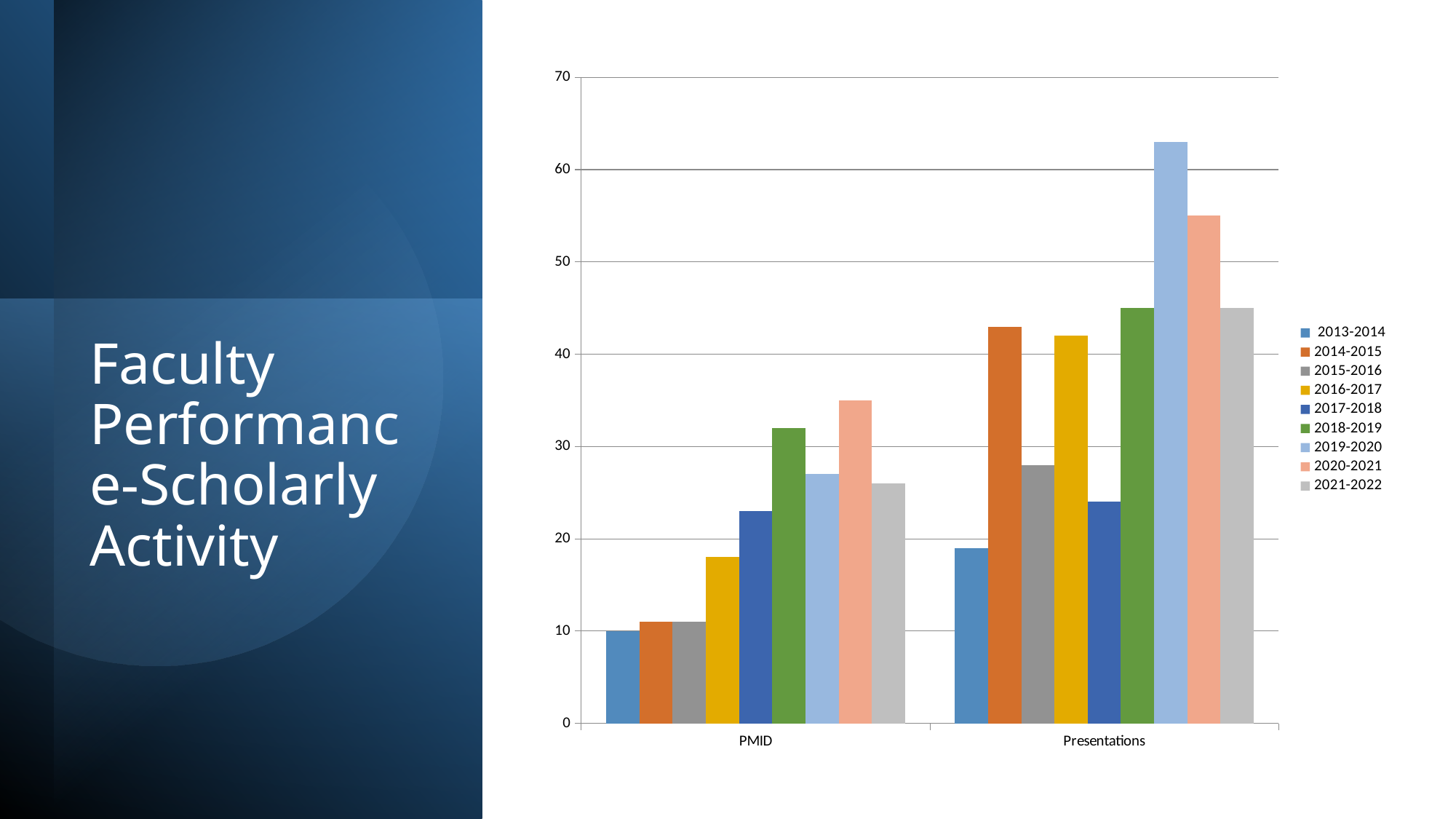
Is the value for 2019-2020 Presentations greater or less than 60? greater Is the value for 2016-2017 PMID greater or less than 20? less Is the value for 2020-2021 PMID greater or less than 30? greater Which series has the highest value for PMID? 2020-2021 Which series has the lowest value for PMID? 2013-2014 What is the title of the slide containing the chart? Faculty Performance-Scholarly Activity Which series has the highest value for Presentations? 2019-2020 Which is larger for PMID: the 2018-2019 value or the 2019-2020 value? 2018-2019 How many categories are shown on the x axis of the chart? 2 What kind of chart is shown on the slide? bar chart Which series has the lowest value for Presentations? 2013-2014 How many series does the chart's legend list? 9